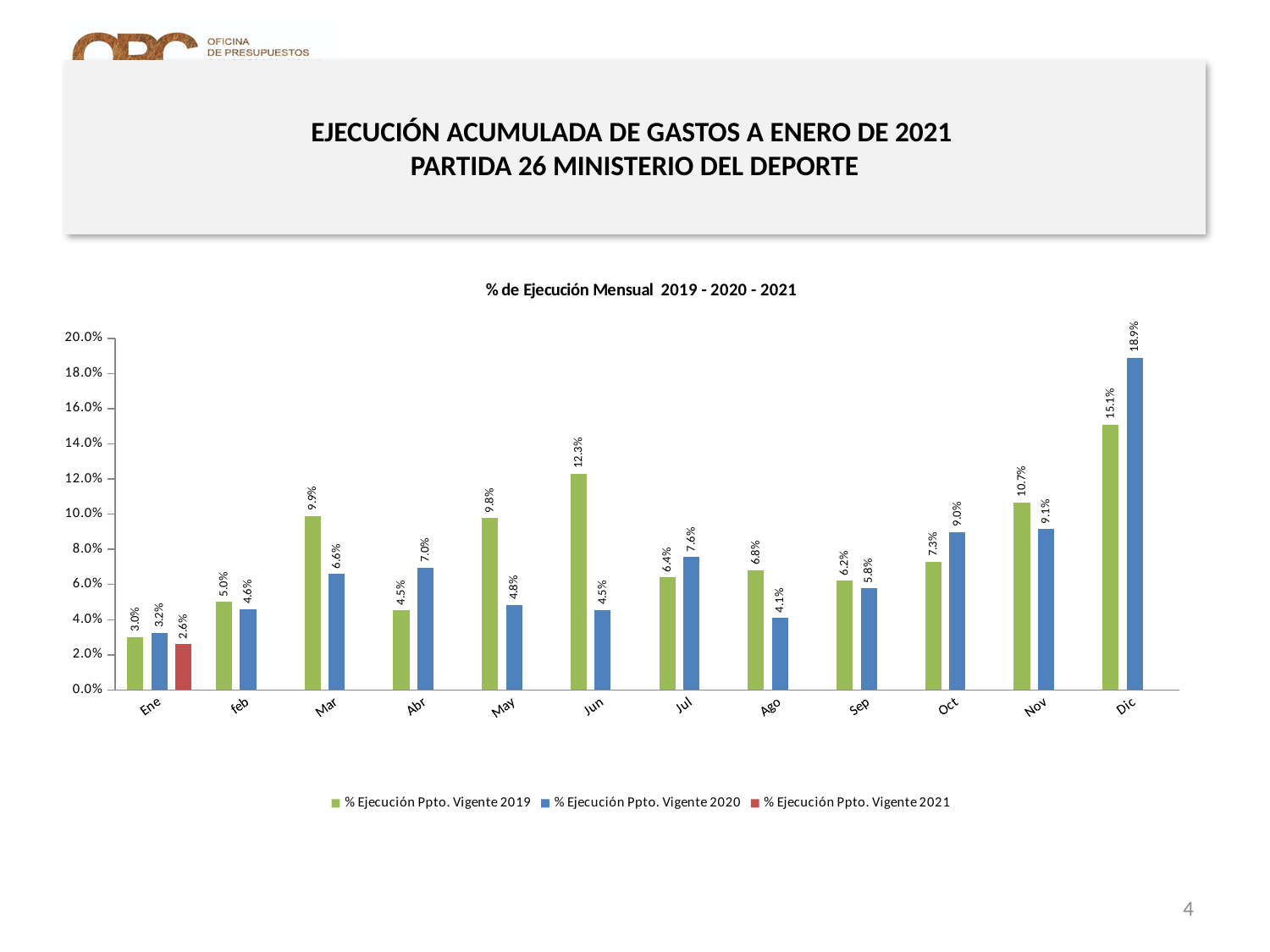
What kind of chart is shown on the slide? Bar chart Which month has the lowest value for % Ejecución Ppto. Vigente 2020? Ene What is the value of % Ejecución Ppto. Vigente 2020 for Dic? 18.9% Which month has the highest value for % Ejecución Ppto. Vigente 2019? Dic How many series does the legend list? 3 How many months are shown on the x axis? 12 What is the value of % Ejecución Ppto. Vigente 2020 for Abr? 7.0% Is the value of % Ejecución Ppto. Vigente 2019 for Nov greater or less than 10.0%? greater What is the value of % Ejecución Ppto. Vigente 2021 for Ene? 2.6% Which is larger for Mar: the 2019 value or the 2020 value? 2019 What is the value of % Ejecución Ppto. Vigente 2019 for Jun? 12.3% What is the difference between the 2020 and 2019 values for Dic? 3.8%